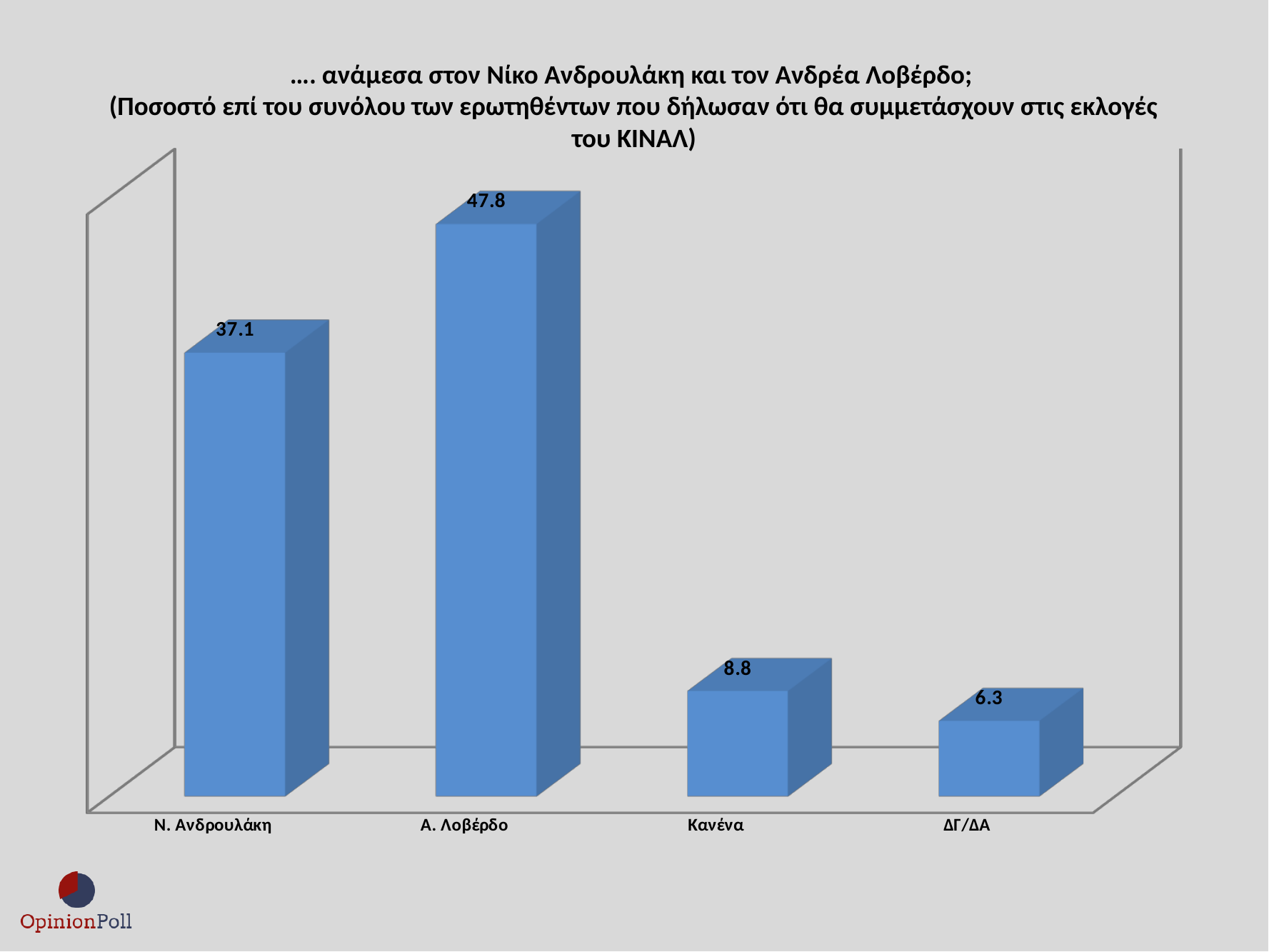
Which category has the lowest value? ΔΓ/ΔΑ What is the value for ΔΓ/ΔΑ? 6.3 Which category has the highest value? Α. Λοβέρδο What kind of chart is shown on the slide? Bar chart What is the difference between the values for Α. Λοβέρδο and Ν. Ανδρουλάκη? 10.7 Which is larger, the value for Ν. Ανδρουλάκη or the value for Κανένα? Ν. Ανδρουλάκη What is the value for Κανένα? 8.8 What is the value for Ν. Ανδρουλάκη? 37.1 What is the difference between the values for Κανένα and ΔΓ/ΔΑ? 2.5 What is the value for Α. Λοβέρδο? 47.8 What colour are the bars in the chart? Blue How many categories are shown on the chart? 4